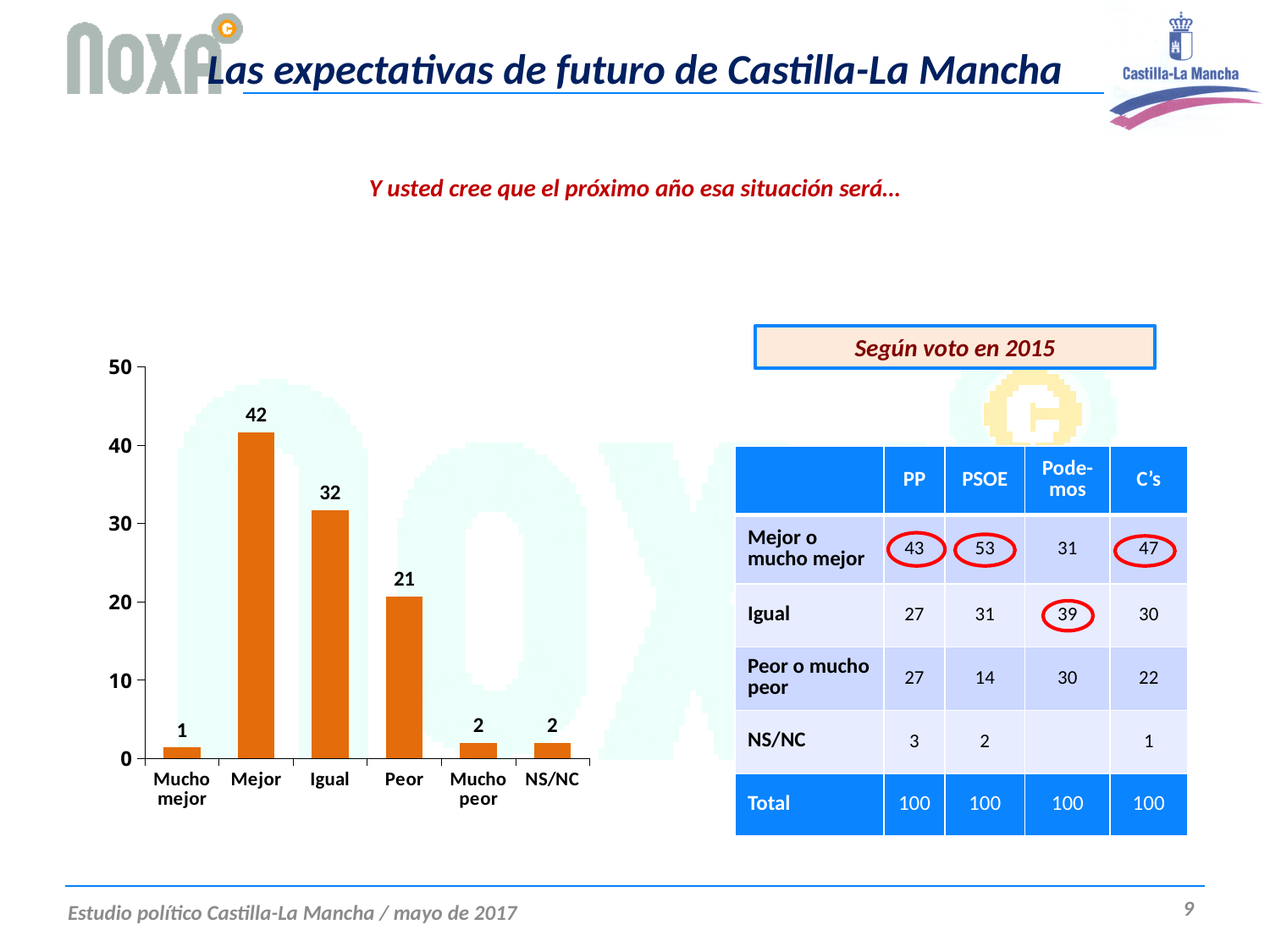
What kind of chart is shown on the slide? bar chart What is the value for "Mejor" in the bar chart? 42 Which category has the highest value in the bar chart? Mejor Which is larger in the bar chart, the value for "Igual" or the value for "Peor"? Igual How many categories are shown on the x axis of the bar chart? 6 What is the value for "Igual" in the bar chart? 32 What is the maximum value shown on the vertical axis of the bar chart? 50 What is the value for "Peor" in the bar chart? 21 Is the value for "Mejor" in the bar chart greater or less than 40? greater Which category has the lowest value in the bar chart? Mucho mejor What is the difference between the values for "Mejor" and "Igual" in the bar chart? 10 What is the value for "Mucho mejor" in the bar chart? 1